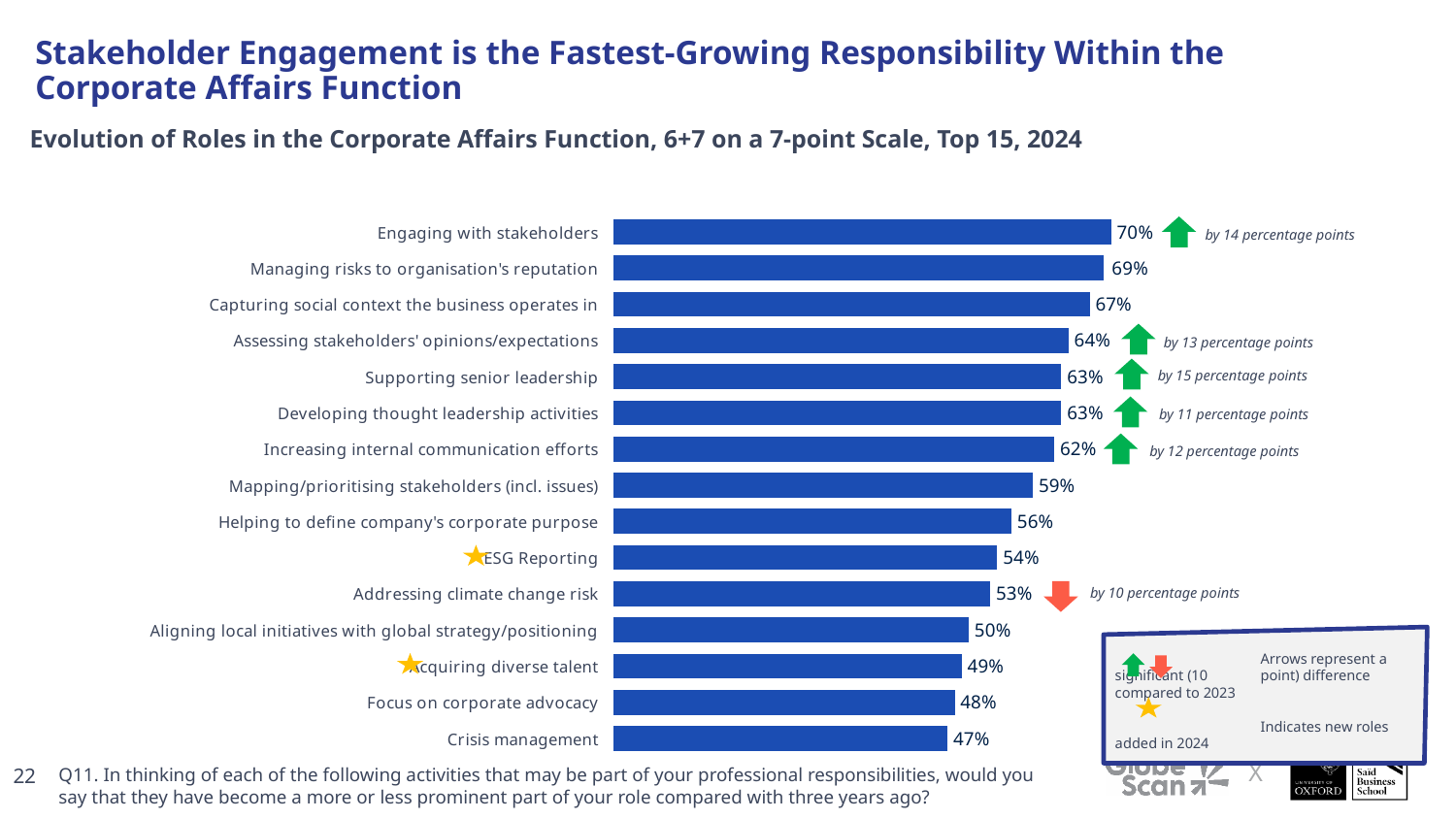
What is the value for Engaging with stakeholders? 70% By how many percentage points did Engaging with stakeholders increase compared to 2023, according to the annotation? 14 percentage points What is the value for ESG Reporting? 54% What is the value for Crisis management? 47% Which is larger, the value for Supporting senior leadership or the value for Focus on corporate advocacy? Supporting senior leadership Which category is marked with a red downward arrow? Addressing climate change risk What is the value for Addressing climate change risk? 53% How many categories are shown in the chart? 15 What is the difference between the values for Engaging with stakeholders and Crisis management? 23 percentage points What kind of chart is shown on the slide? Bar chart Which category has the highest value? Engaging with stakeholders Which category has the lowest value? Crisis management